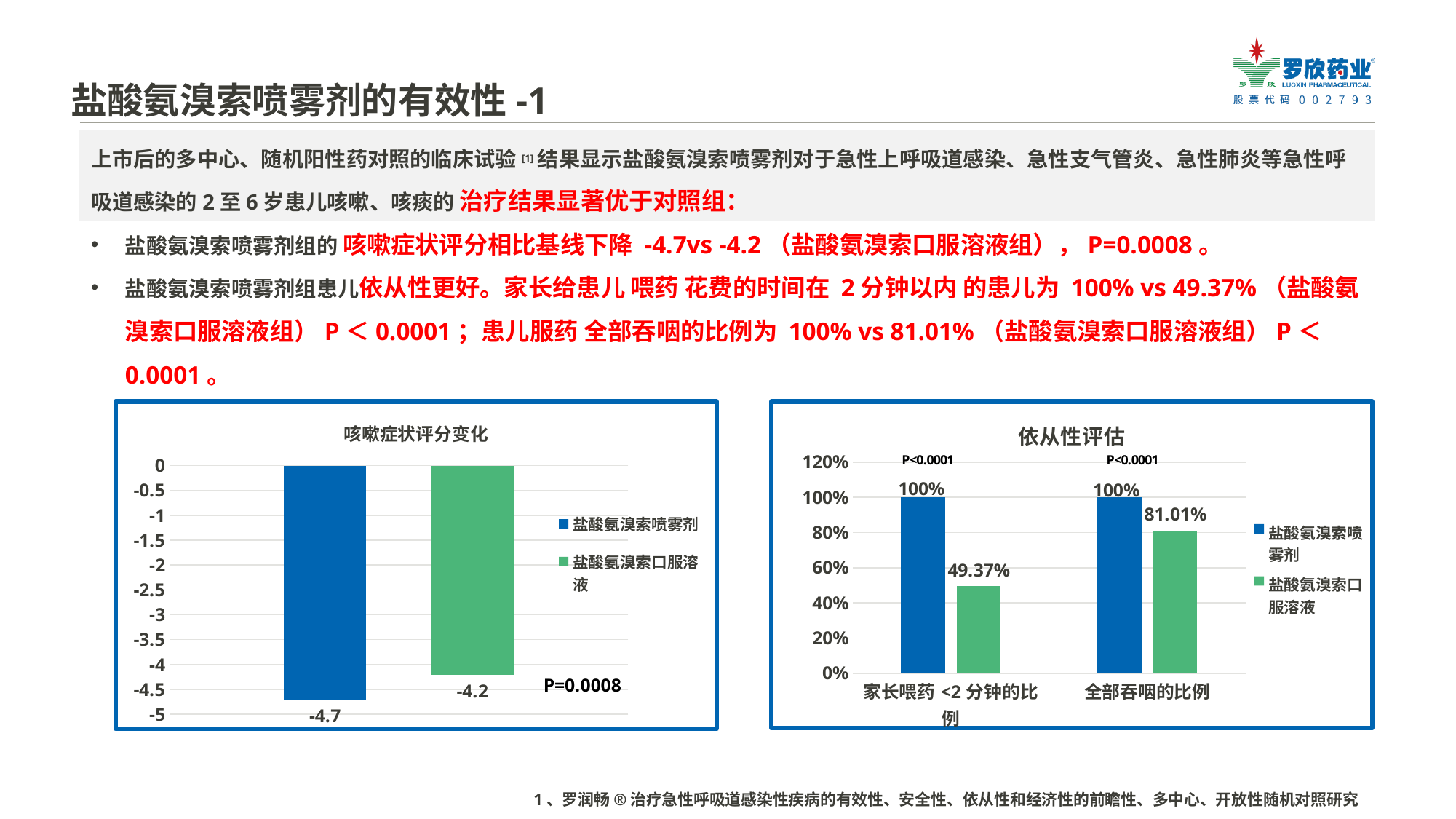
In the chart titled 咳嗽症状评分变化, what is the value for 盐酸氨溴索口服溶液? -4.2 In the chart titled 咳嗽症状评分变化, what is the value for 盐酸氨溴索喷雾剂? -4.7 In the chart titled 咳嗽症状评分变化, how many series does the legend list? 2 In the chart titled 依从性评估, which series has the larger value in the category 全部吞咽的比例? 盐酸氨溴索喷雾剂 In the chart titled 依从性评估, what is the difference between the two series in the category 家长喂药<2分钟的比例? 50.63% In the chart titled 依从性评估, what is the value for 盐酸氨溴索口服溶液 in the category 家长喂药<2分钟的比例? 49.37% In the chart titled 依从性评估, how many categories are shown on the x axis? 2 What kind of chart is the chart titled 依从性评估? Bar chart In the chart titled 依从性评估, what is the value for 盐酸氨溴索喷雾剂 in the category 全部吞咽的比例? 100% In the chart titled 咳嗽症状评分变化, what is the difference between the values for 盐酸氨溴索喷雾剂 and 盐酸氨溴索口服溶液? 0.5 In the chart titled 依从性评估, what is the value for 盐酸氨溴索口服溶液 in the category 全部吞咽的比例? 81.01% In the chart titled 咳嗽症状评分变化, what P value is printed on the chart? P=0.0008